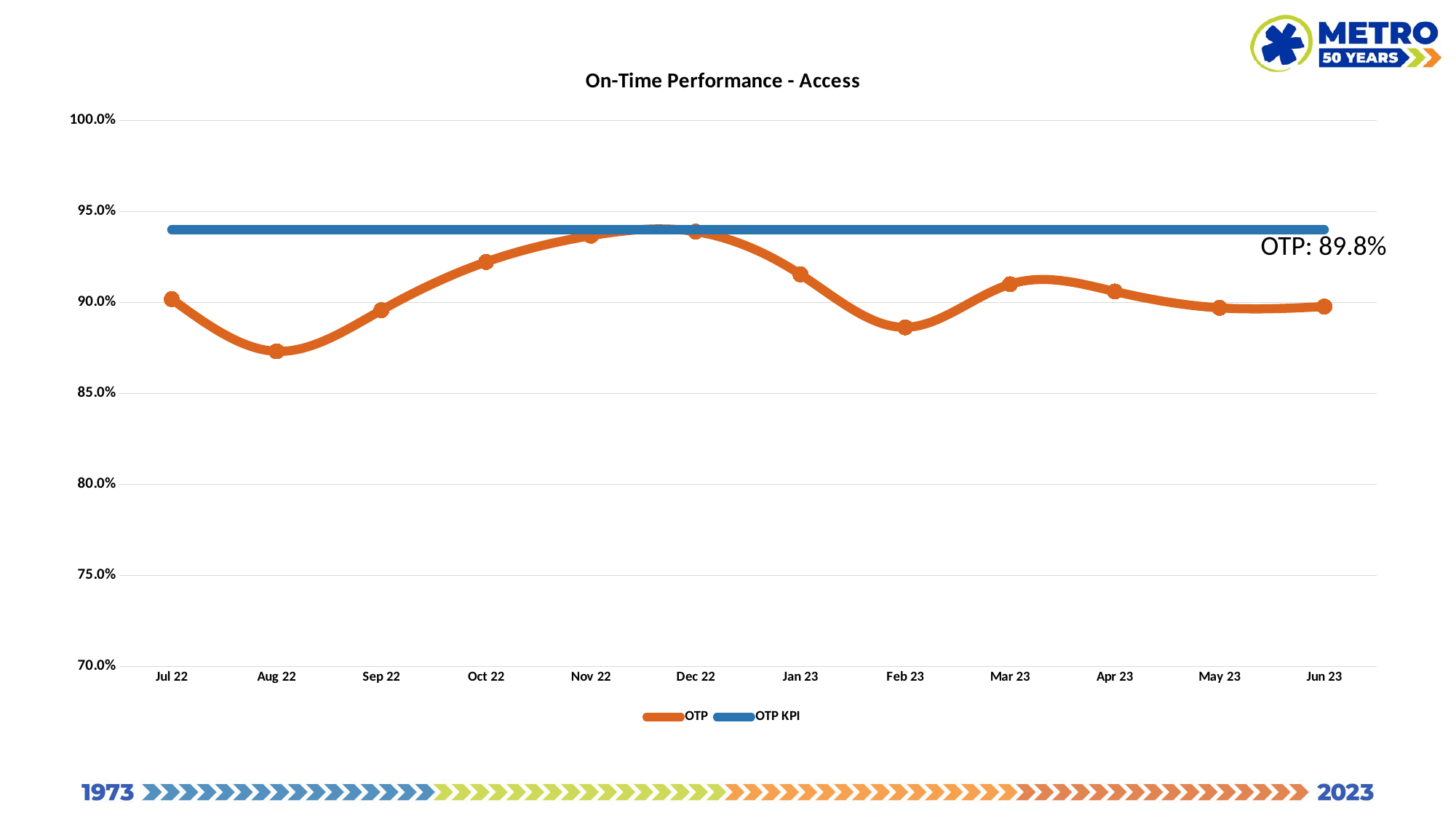
Which is larger, the OTP value for Oct 22 or for Aug 22? Oct 22 Is the OTP value for Oct 22 greater or less than 90.0%? greater Does the OTP line rise or fall from Aug 22 to Nov 22? rise What is the title of the chart? On-Time Performance - Access What OTP value is annotated on the chart? 89.8% How many series does the legend list? 2 Which month has the lowest OTP value? Aug 22 Is the OTP value for Aug 22 greater or less than 90.0%? less How many months are plotted along the x axis? 12 What kind of chart is shown on the slide? line chart Is the OTP value for Nov 22 greater or less than 95.0%? less What colour is the OTP KPI line? blue